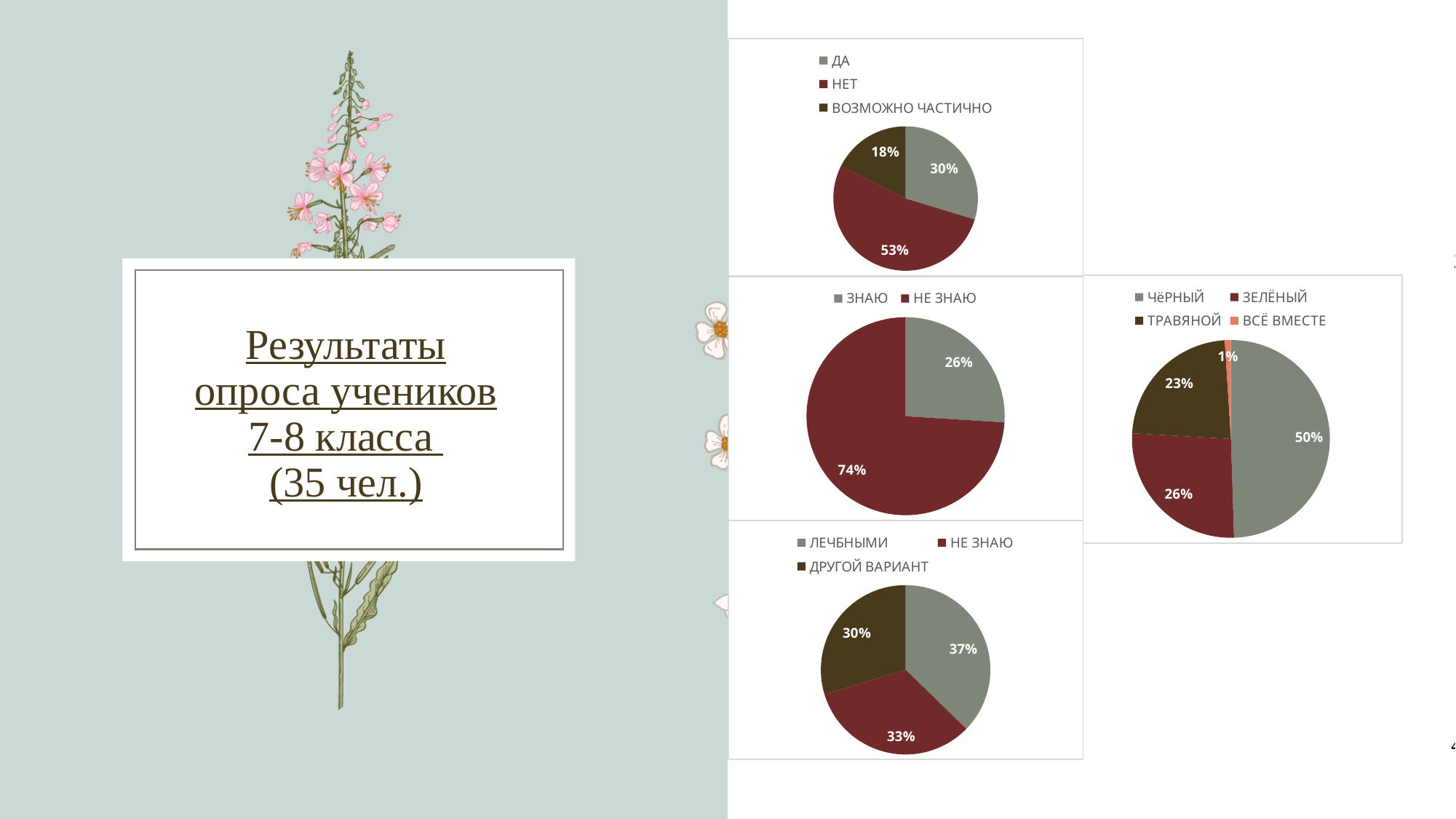
In the top pie chart on the left (legend ДА, НЕТ, ВОЗМОЖНО ЧАСТИЧНО), what share is labelled for НЕТ? 53% In the pie chart on the right (legend ЧёРНЫЙ, ЗЕЛЁНЫЙ, ТРАВЯНОЙ, ВСЁ ВМЕСТЕ), which category has the smallest slice? ВСЁ ВМЕСТЕ In the bottom pie chart on the left (legend ЛЕЧБНЫМИ, НЕ ЗНАЮ, ДРУГОЙ ВАРИАНТ), which category has the largest slice? ЛЕЧБНЫМИ In the pie chart on the right (legend ЧёРНЫЙ, ЗЕЛЁНЫЙ, ТРАВЯНОЙ, ВСЁ ВМЕСТЕ), which is larger, ЗЕЛЁНЫЙ or ТРАВЯНОЙ? ЗЕЛЁНЫЙ In the middle pie chart on the left (legend ЗНАЮ, НЕ ЗНАЮ), how many entries does the legend list? 2 In the top pie chart on the left (legend ДА, НЕТ, ВОЗМОЖНО ЧАСТИЧНО), how many slices does the pie have? 3 In the middle pie chart on the left (legend ЗНАЮ, НЕ ЗНАЮ), what is the difference between the НЕ ЗНАЮ and ЗНАЮ shares? 48% In the top pie chart on the left (legend ДА, НЕТ, ВОЗМОЖНО ЧАСТИЧНО), which category has the smallest slice? ВОЗМОЖНО ЧАСТИЧНО What type of chart is used for all the charts on this slide? Pie chart In the pie chart on the right (legend ЧёРНЫЙ, ЗЕЛЁНЫЙ, ТРАВЯНОЙ, ВСЁ ВМЕСТЕ), what share is labelled for ЧёРНЫЙ? 50% In the middle pie chart on the left (legend ЗНАЮ, НЕ ЗНАЮ), what share is labelled for НЕ ЗНАЮ? 74% In the bottom pie chart on the left (legend ЛЕЧБНЫМИ, НЕ ЗНАЮ, ДРУГОЙ ВАРИАНТ), what share is labelled for ДРУГОЙ ВАРИАНТ? 30%